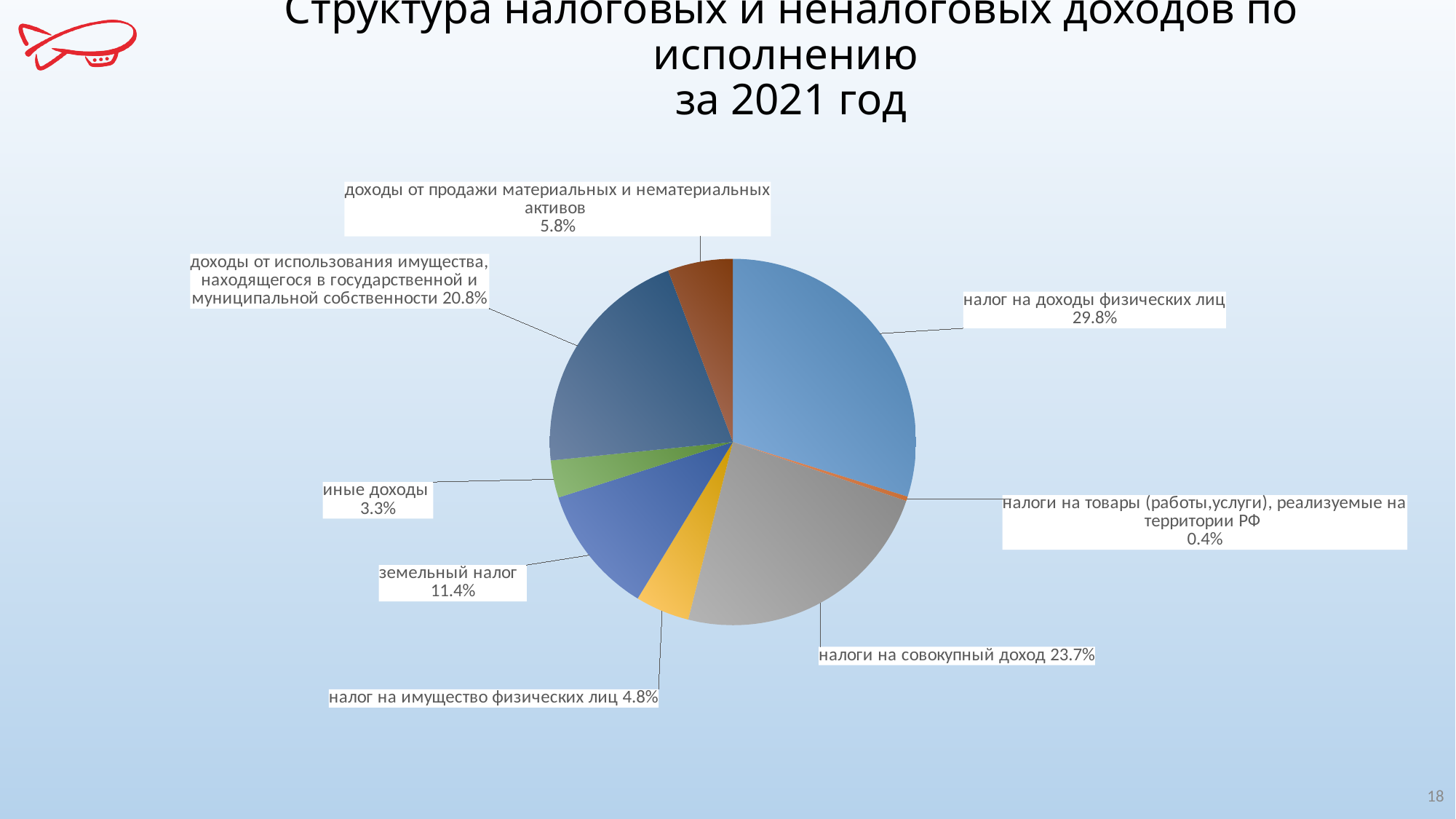
What share of the pie is 'налоги на совокупный доход'? 23.7% What share of the pie is 'налог на доходы физических лиц'? 29.8% How many slices does the pie chart have? 8 What share of the pie is 'доходы от продажи материальных и нематериальных активов'? 5.8% Which category has the largest share of the pie? налог на доходы физических лиц Which category has the smallest share of the pie? налоги на товары (работы,услуги), реализуемые на территории РФ What kind of chart is shown on the slide? pie chart What is the difference in percentage points between 'налог на доходы физических лиц' and 'налоги на совокупный доход'? 6.1 Which is larger: 'земельный налог' or 'налог на имущество физических лиц'? земельный налог What year does the chart title say the data is for? 2021